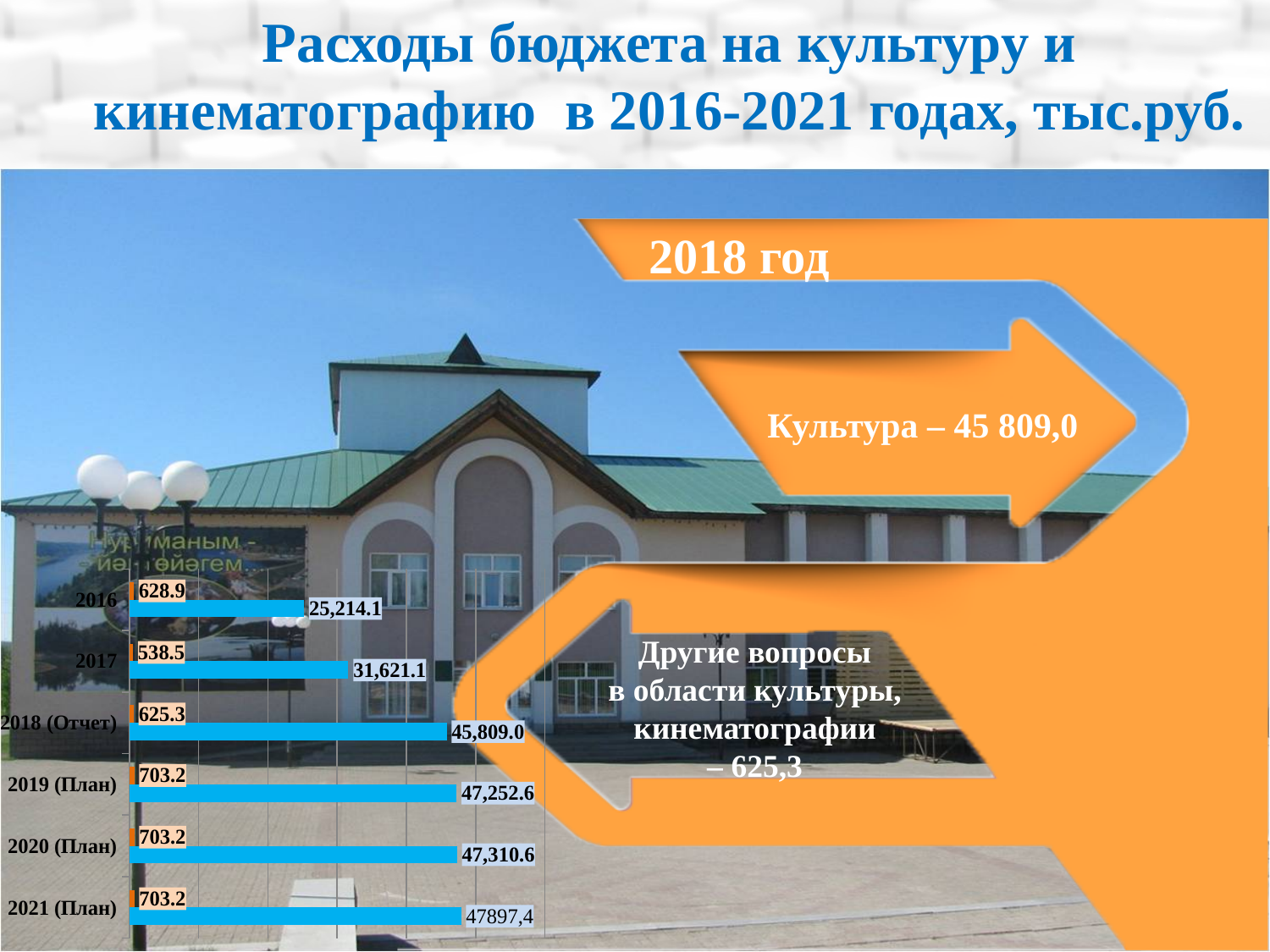
How many categories are shown on the chart? 6 Which is larger, the blue bar for 2017 or the blue bar for 2018 (Отчет)? 2018 (Отчет) What is the value of the blue bar for 2021 (План)? 47897,4 Which category has the highest blue bar value? 2021 (План) What is the value of the orange bar for 2019 (План)? 703.2 What is the value of the orange bar for 2017? 538.5 Which category has the lowest blue bar value? 2016 What kind of chart is shown on the slide? bar chart What is the value of the blue bar for 2018 (Отчет)? 45,809.0 Which category has the lowest orange bar value? 2017 What is the value of the blue bar for 2016? 25,214.1 Do the blue bar values rise or fall from 2016 to 2021 (План)? rise